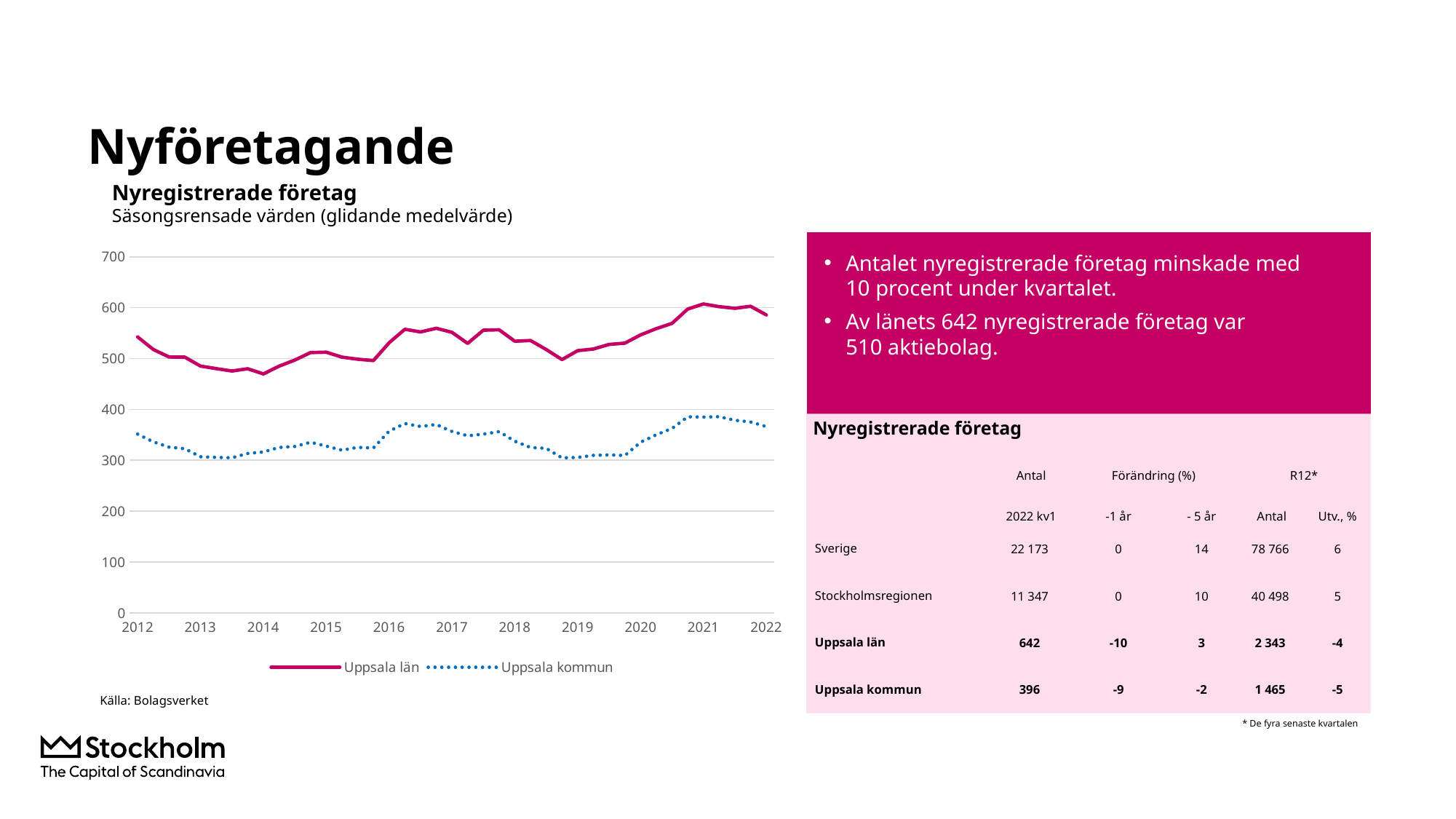
Is the value for Uppsala kommun in 2012 greater or less than 400? less Which series has the higher value in 2022, Uppsala län or Uppsala kommun? Uppsala län Does the Uppsala kommun line rise or fall between 2019 and 2021? Rise How many year labels are shown on the x axis of the chart? 11 Does the Uppsala län line rise or fall between 2012 and 2014? Fall Is the value for Uppsala kommun in 2019 greater or less than 400? less Which two series are listed in the chart legend? Uppsala län and Uppsala kommun What is the title of the chart? Nyregistrerade företag Is the value for Uppsala län in 2012 greater or less than 500? greater What kind of chart is shown on the slide? Line chart How many series does the chart legend list? 2